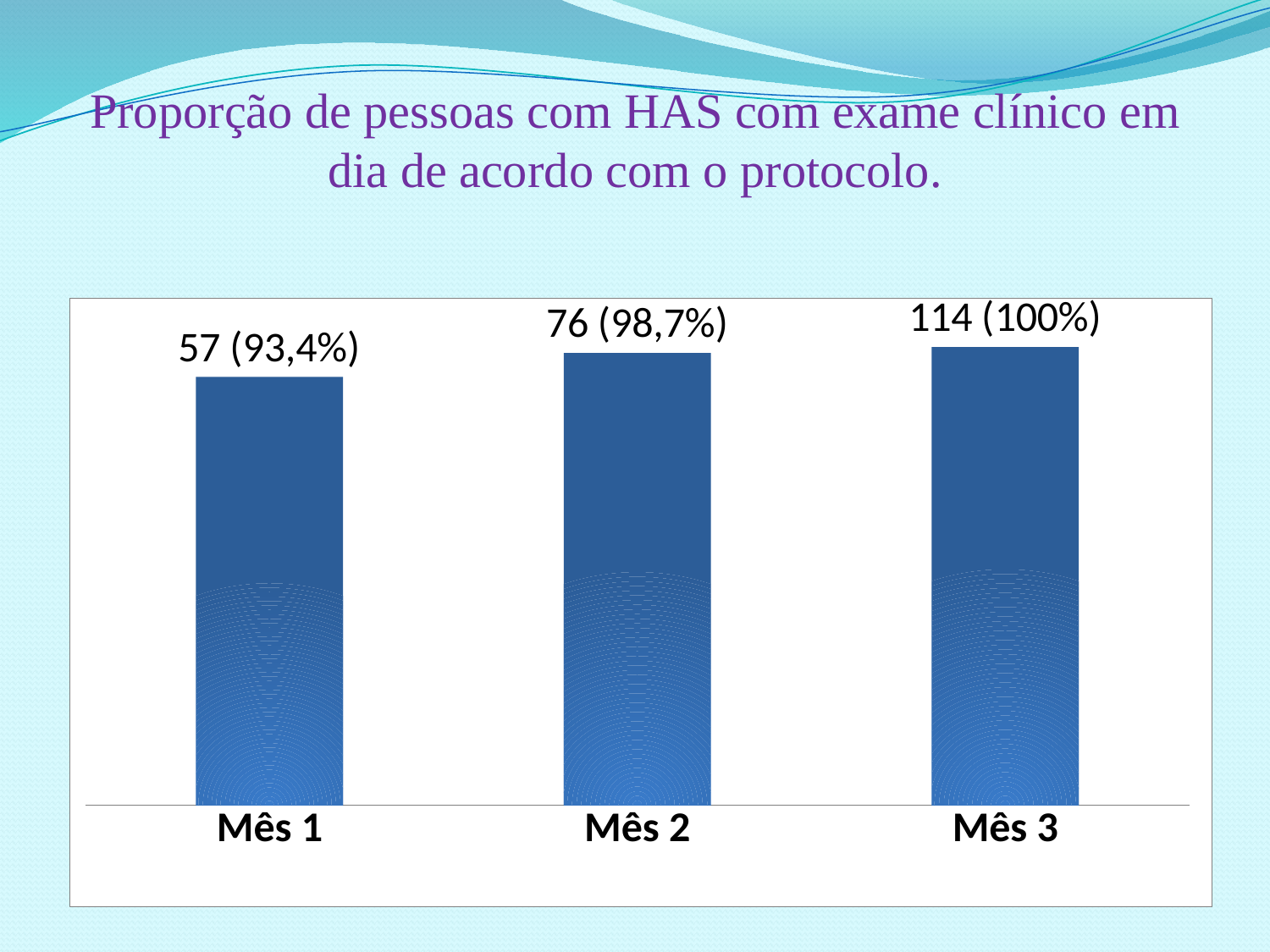
What is the data label shown for Mês 2? 76 (98,7%) What kind of chart is shown on the slide? Bar chart What is the data label shown for Mês 1? 57 (93,4%) What is the difference between the counts shown for Mês 3 and Mês 1? 57 What percentage is shown for Mês 2? 98,7% Which month has the highest percentage? Mês 3 Which is larger, the percentage for Mês 1 or for Mês 2? Mês 2 What is the difference in percentage points between Mês 3 and Mês 1? 6,6 What is the data label shown for Mês 3? 114 (100%) Which month has the lowest percentage? Mês 1 How many months are shown on the x axis? 3 Do the percentages rise or fall from Mês 1 to Mês 3? Rise